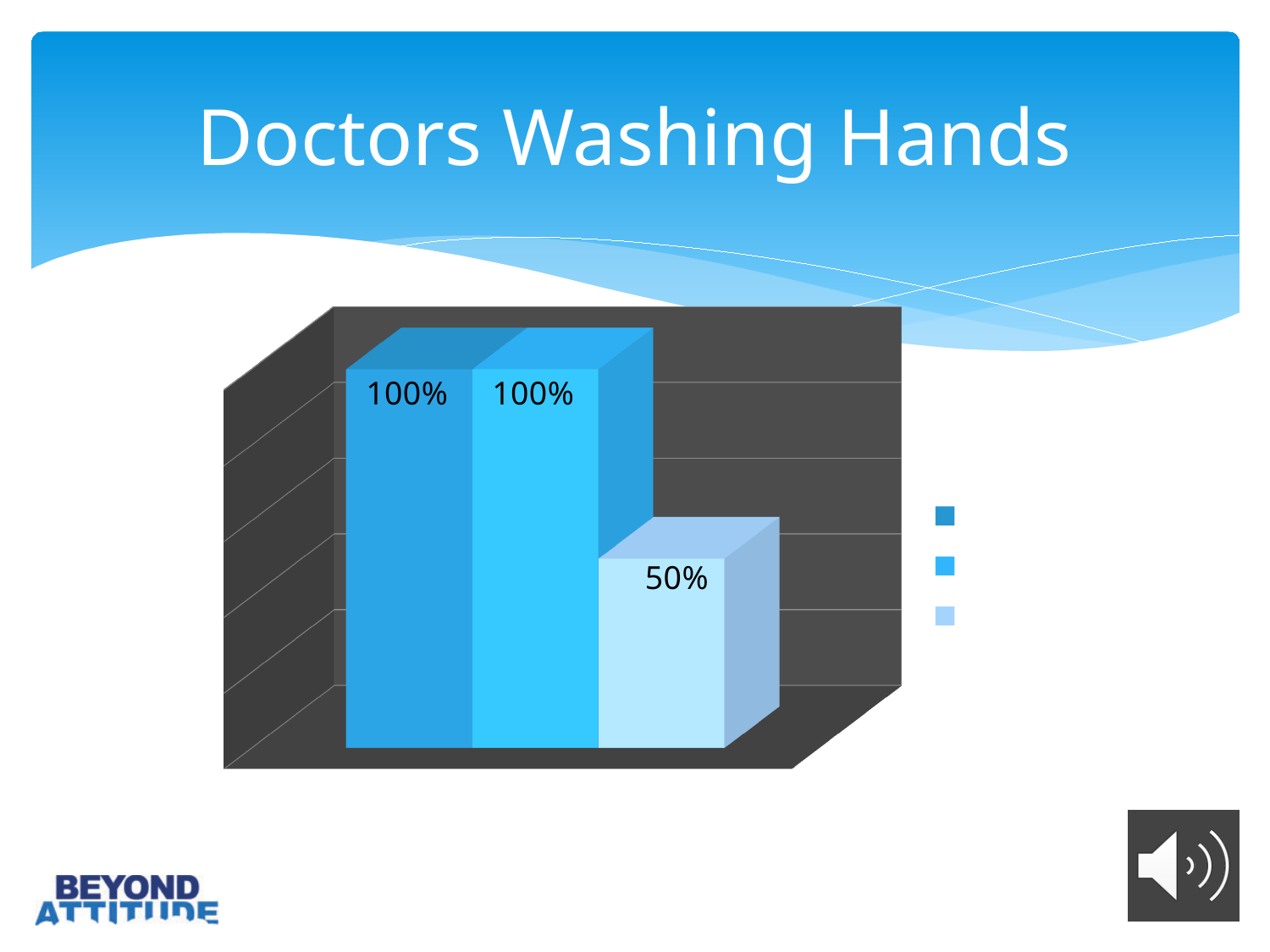
What is the title of the slide containing the chart? Doctors Washing Hands Which bar has the lowest value? the rightmost bar What is the difference between the leftmost bar's value and the rightmost bar's value? 50% How many entries does the chart's legend list? 3 What value is labelled on the rightmost bar? 50% Which is larger, the middle bar or the rightmost bar? the middle bar How many bars are plotted in the chart? 3 What is the highest value shown on any bar? 100% What kind of chart is shown on the slide? bar chart What value is labelled on the leftmost bar? 100% What value is labelled on the middle bar? 100% Do the bar values rise or fall from left to right across the chart? fall